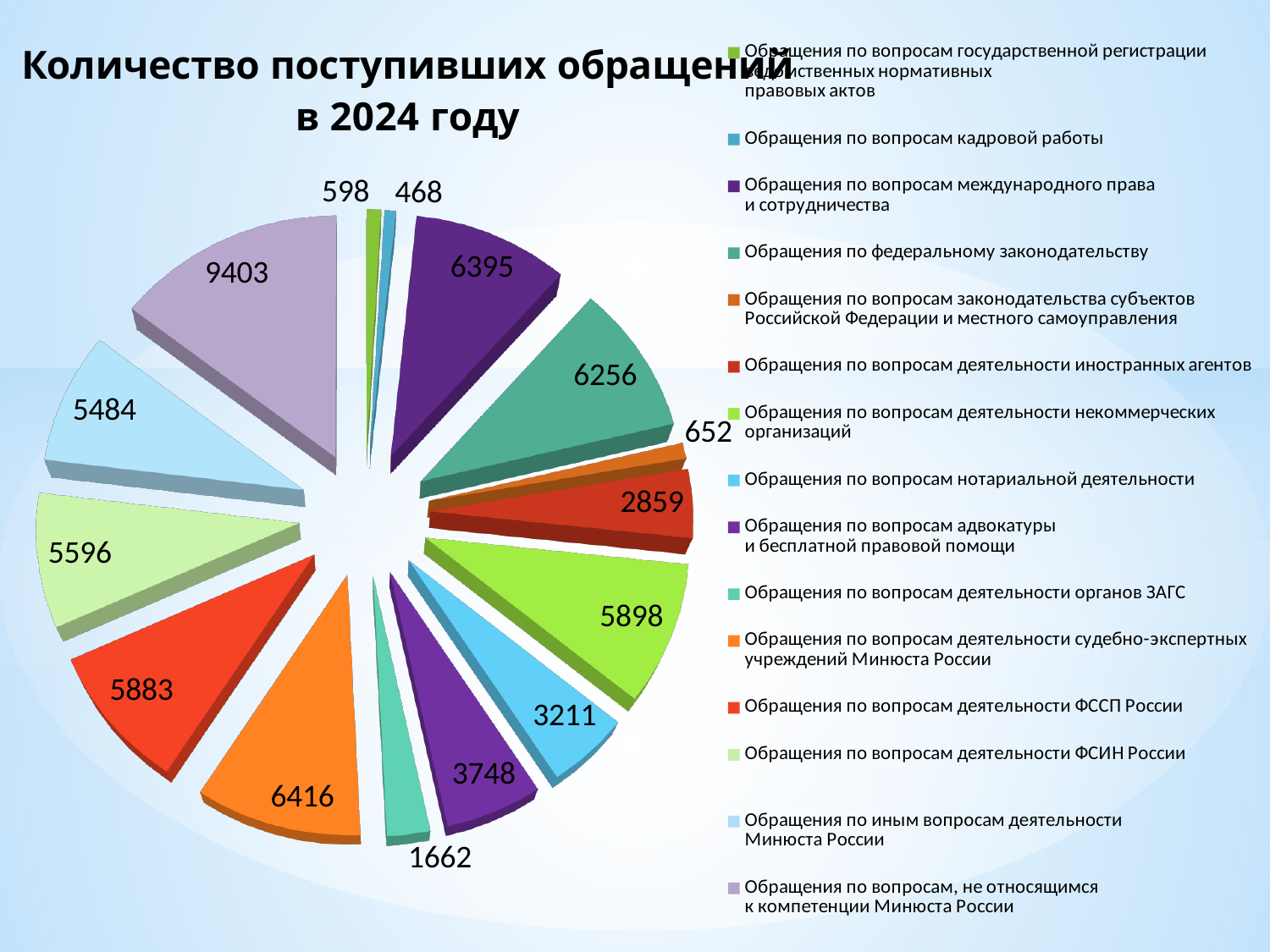
How many categories does the legend list? 15 What is the value for "Обращения по вопросам деятельности органов ЗАГС"? 1662 What is the value for "Обращения по вопросам, не относящимся к компетенции Минюста России"? 9403 What is the title of the chart? Количество поступивших обращений в 2024 году What type of chart is shown on the slide? Pie chart Which category has the smallest slice? Обращения по вопросам кадровой работы Which is larger: the value for "Обращения по вопросам международного права и сотрудничества" or for "Обращения по федеральному законодательству"? Обращения по вопросам международного права и сотрудничества What is the value for "Обращения по вопросам деятельности иностранных агентов"? 2859 What is the difference between the values for "Обращения по вопросам деятельности судебно-экспертных учреждений Минюста России" and "Обращения по вопросам деятельности ФССП России"? 533 What is the value for "Обращения по вопросам нотариальной деятельности"? 3211 What is the value for "Обращения по вопросам кадровой работы"? 468 Which category has the largest slice? Обращения по вопросам, не относящимся к компетенции Минюста России